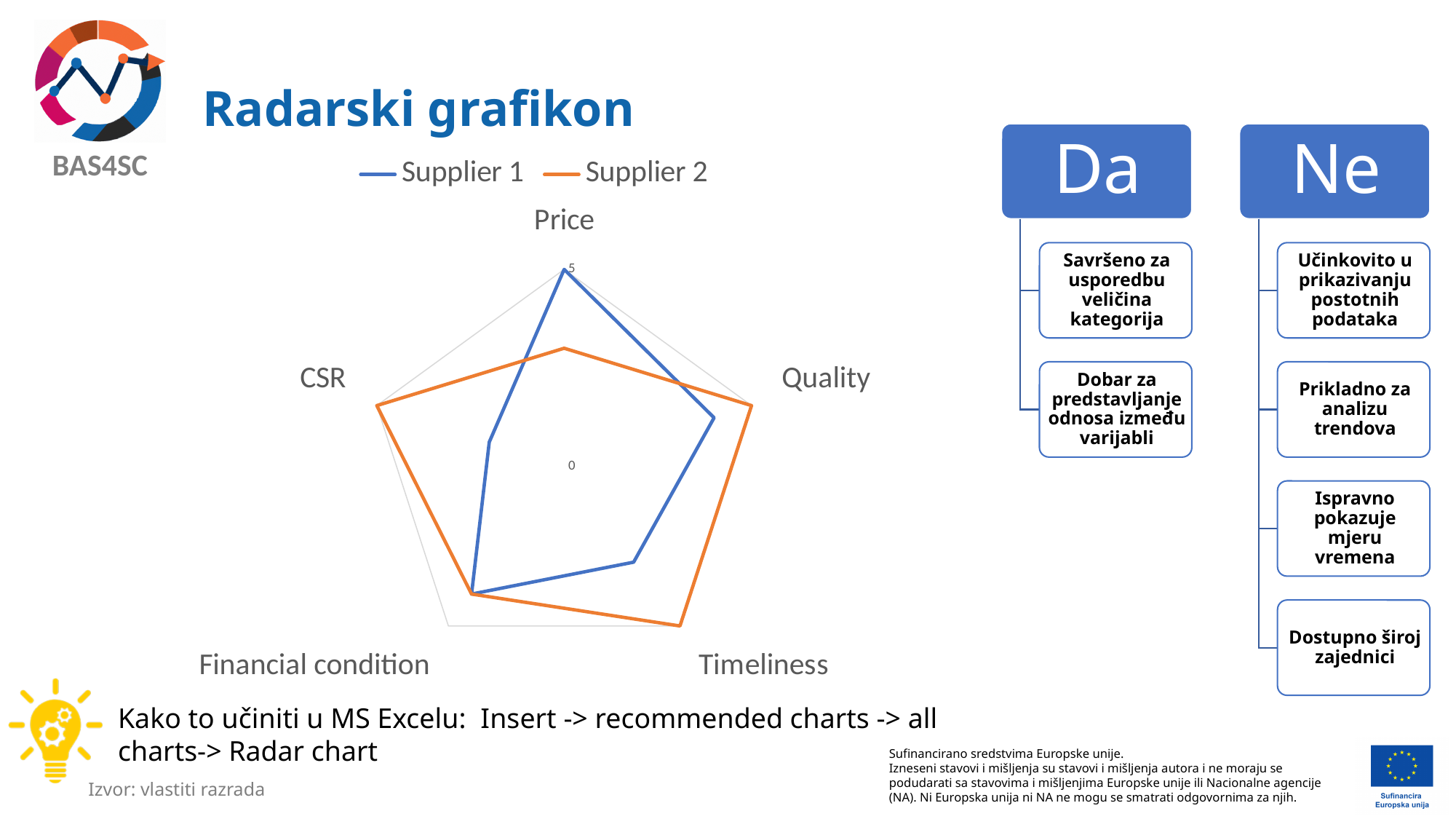
On which category does Supplier 1 have its highest value? Price What are the two series names shown in the chart legend? Supplier 1 and Supplier 2 Which supplier has the higher value for Price? Supplier 1 How many categories (axes) does the radar chart have? 5 What is the value of Supplier 1 for Price? 5 How many series does the chart legend list? 2 Which supplier has the higher value for Timeliness? Supplier 2 On which category does Supplier 2 have its lowest value? Price Which supplier has the higher value for CSR? Supplier 2 On which category does Supplier 1 have its lowest value? CSR What kind of chart is shown on the slide? radar chart